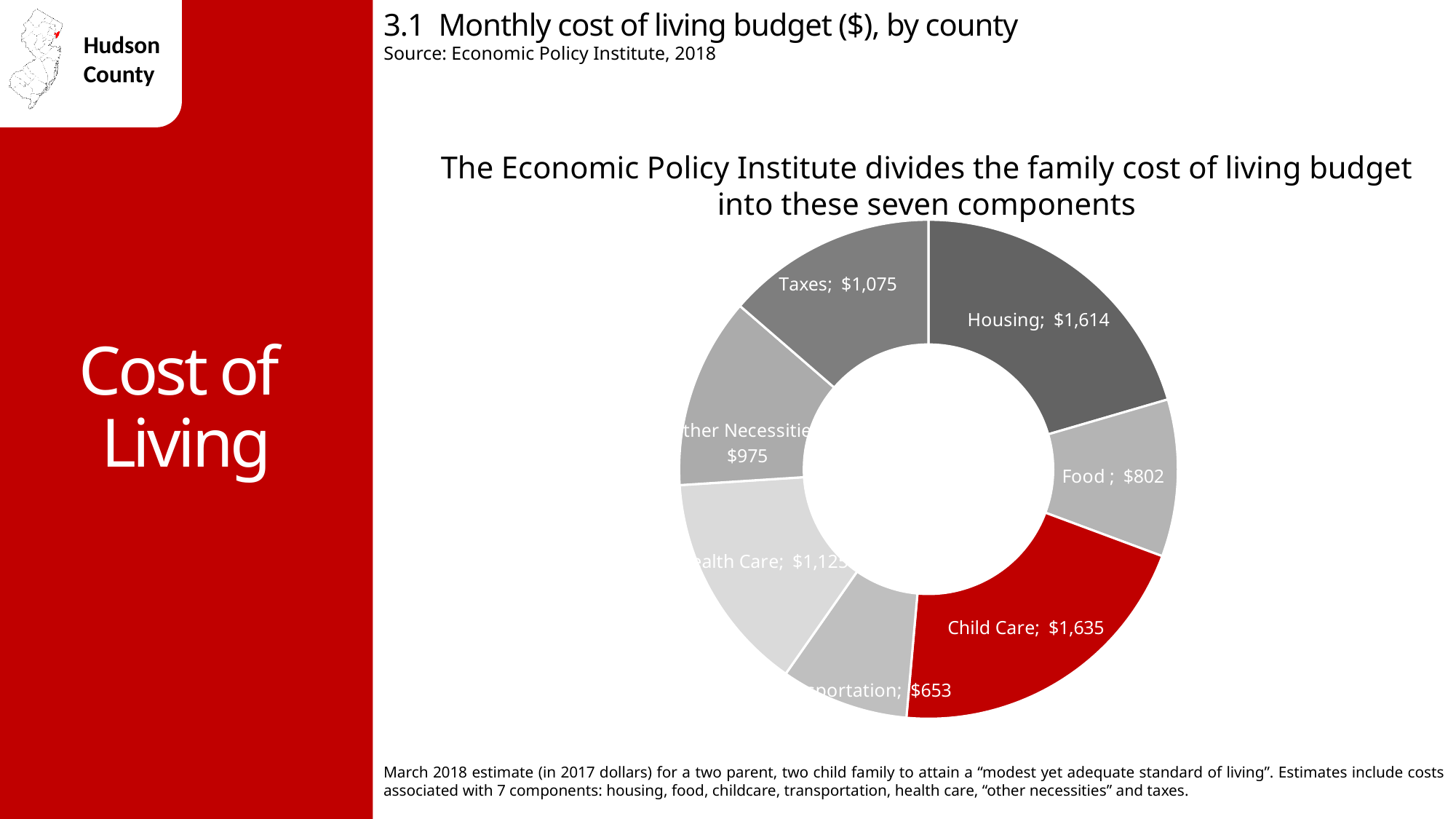
What is the monthly cost for Housing shown on the chart? $1,614 What is the difference between the Housing cost and the Food cost? $812 What type of chart is shown on the slide? Pie (doughnut) chart How many components are shown in the chart? 7 Which component has the smallest monthly cost on the chart? Transportation What is the monthly cost for Food shown on the chart? $802 What is the difference between the Taxes cost and the Other Necessities cost? $100 What is the monthly cost for Transportation shown on the chart? $653 What is the monthly cost for Taxes shown on the chart? $1,075 Which component has the largest monthly cost on the chart? Child Care Which is larger, the cost for Housing or the cost for Food? Housing What is the monthly cost for Child Care shown on the chart? $1,635